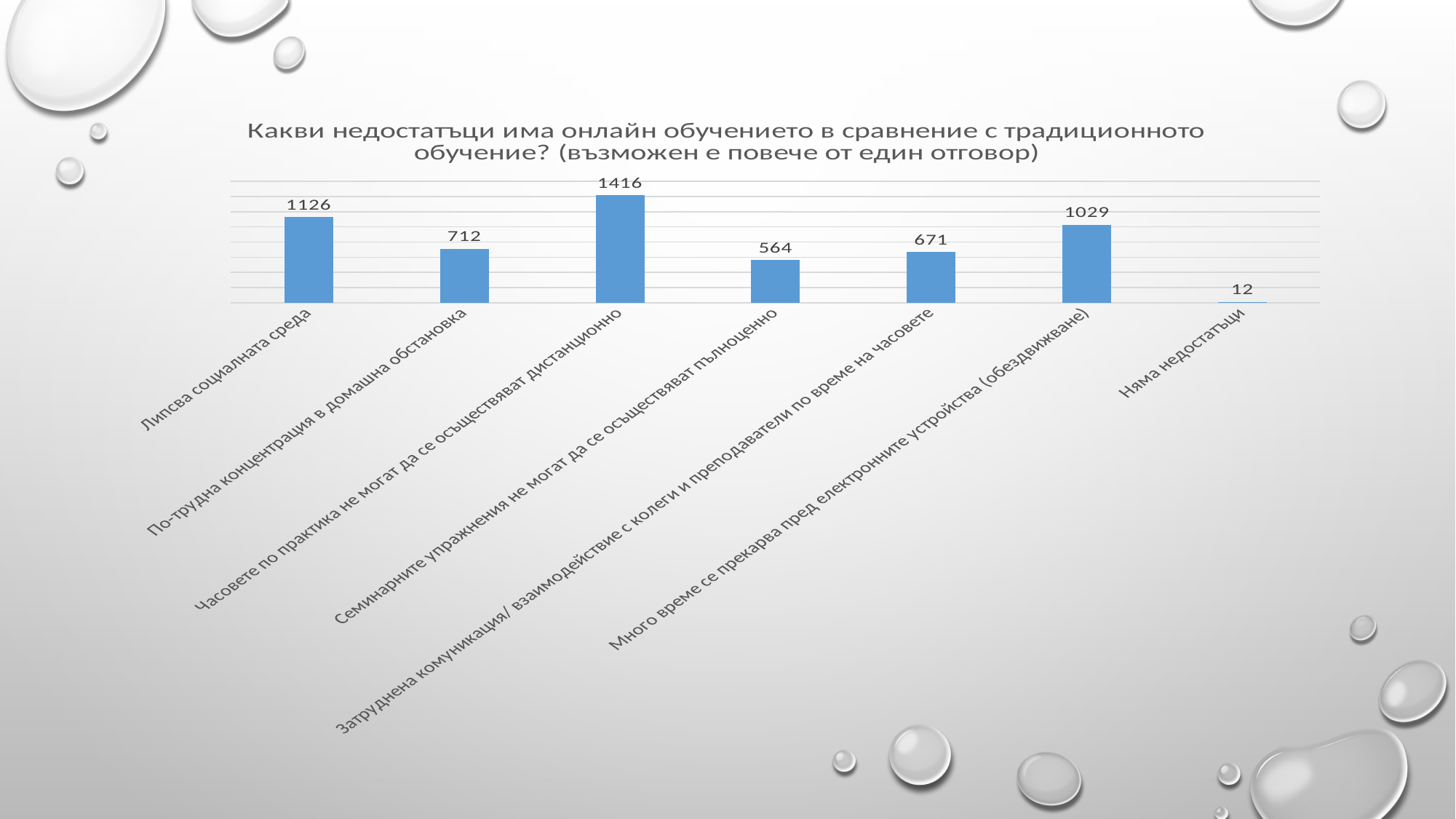
What is the title of the chart? Какви недостатъци има онлайн обучението в сравнение с традиционното обучение? (възможен е повече от един отговор) What is the value for "Няма недостатъци"? 12 What is the difference between the highest and lowest values in the chart? 1404 Which is larger: the value for "Семинарните упражнения не могат да се осъществяват пълноценно" or the value for "Затруднена комуникация/ взаимодействие с колеги и преподаватели по време на часовете"? Затруднена комуникация/ взаимодействие с колеги и преподаватели по време на часовете How many categories are shown in the chart? 7 What is the difference between the values for "Липсва социалната среда" and "По-трудна концентрация в домашна обстановка"? 414 Which category has the highest value? Часовете по практика не могат да се осъществяват дистанционно What is the value for "Часовете по практика не могат да се осъществяват дистанционно"? 1416 What kind of chart is shown on the slide? Bar chart What is the value for "Много време се прекарва пред електронните устройства (обездвижване)"? 1029 Which category has the lowest value? Няма недостатъци What is the value for "Липсва социалната среда"? 1126